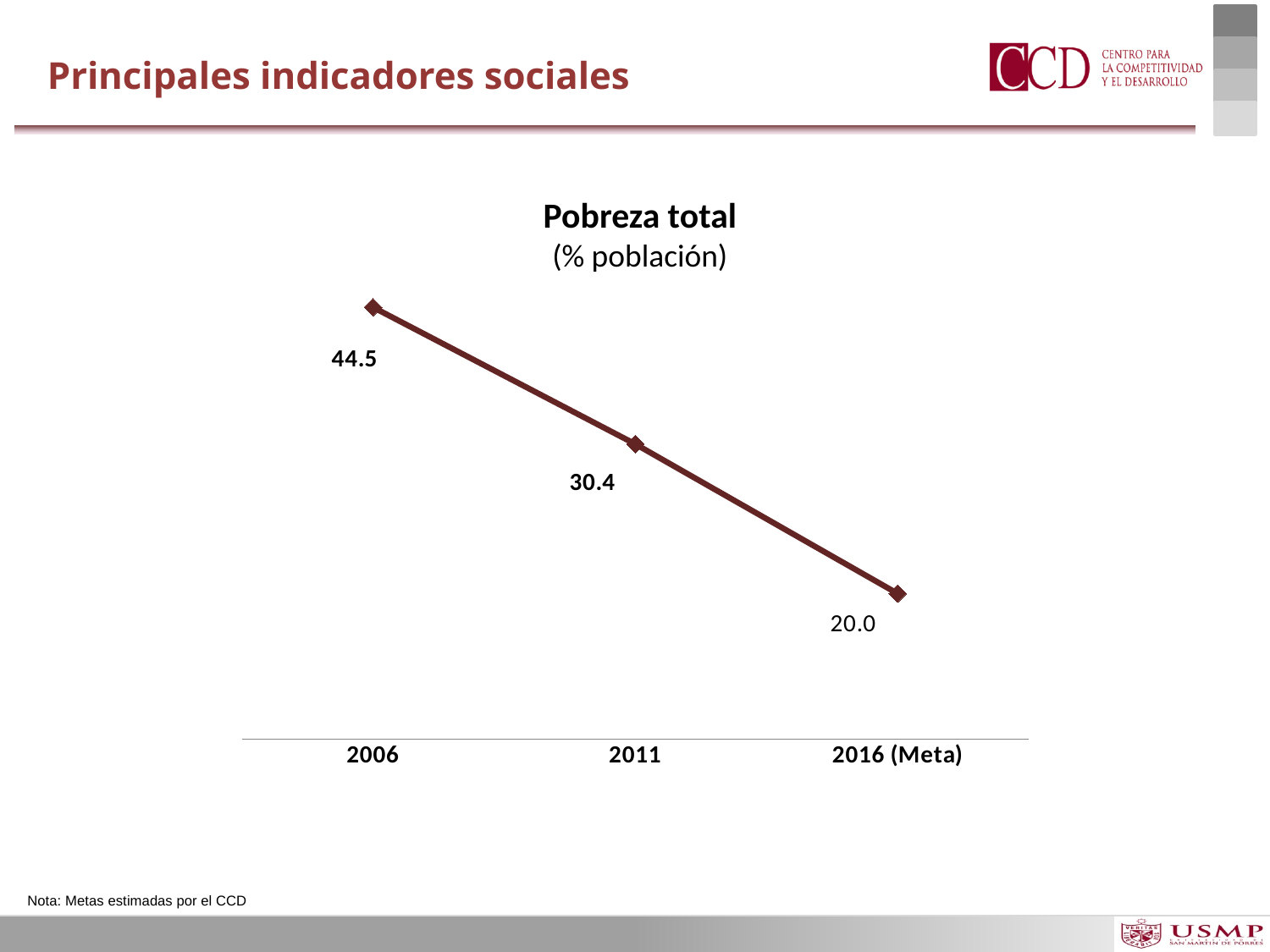
What is the difference between the values for 2011 and 2016 (Meta)? 10.4 Which is larger, the value for 2006 or the value for 2016 (Meta)? 2006 What is the value for 2011? 30.4 Which year has the highest value? 2006 What kind of chart is shown? line chart What is the title of the chart? Pobreza total How many data points are plotted on the chart? 3 What is the difference between the values for 2006 and 2011? 14.1 What is the value for 2006? 44.5 Which year has the lowest value? 2016 (Meta) What is the value for 2016 (Meta)? 20.0 Do the values rise or fall from 2006 to 2016 (Meta)? fall